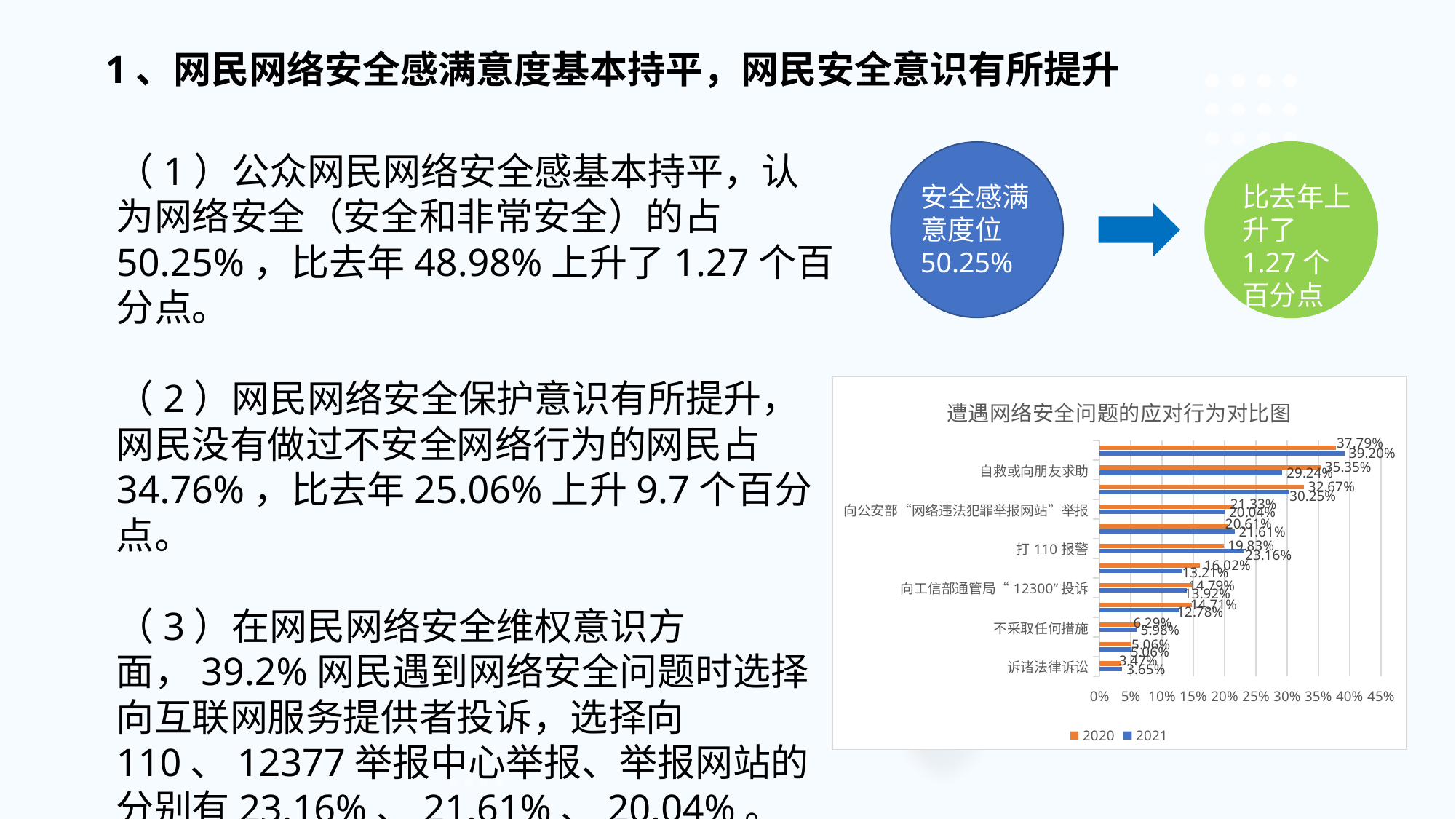
What is the 2021 value for 向公安部“网络违法犯罪举报网站”举报 in the chart? 20.04% Is the 2020 value for 自救或向朋友求助 greater or less than 30%? greater What type of chart is shown on the slide? bar chart What is the title of the chart on the slide? 遭遇网络安全问题的应对行为对比图 What is the difference between the 2021 and 2020 values for 打 110 报警? 3.33% What is the 2020 value for 诉诸法律诉讼 in the chart? 3.47% For 打 110 报警, which series has the larger value, 2020 or 2021? 2021 How many series does the chart's legend list? 2 Which two series are listed in the chart's legend? 2020 and 2021 What is the 2020 value for 打 110 报警 in the chart? 19.83% What is the 2021 value for 不采取任何措施 in the chart? 5.98% What is the 2021 value for 打 110 报警 in the chart? 23.16%